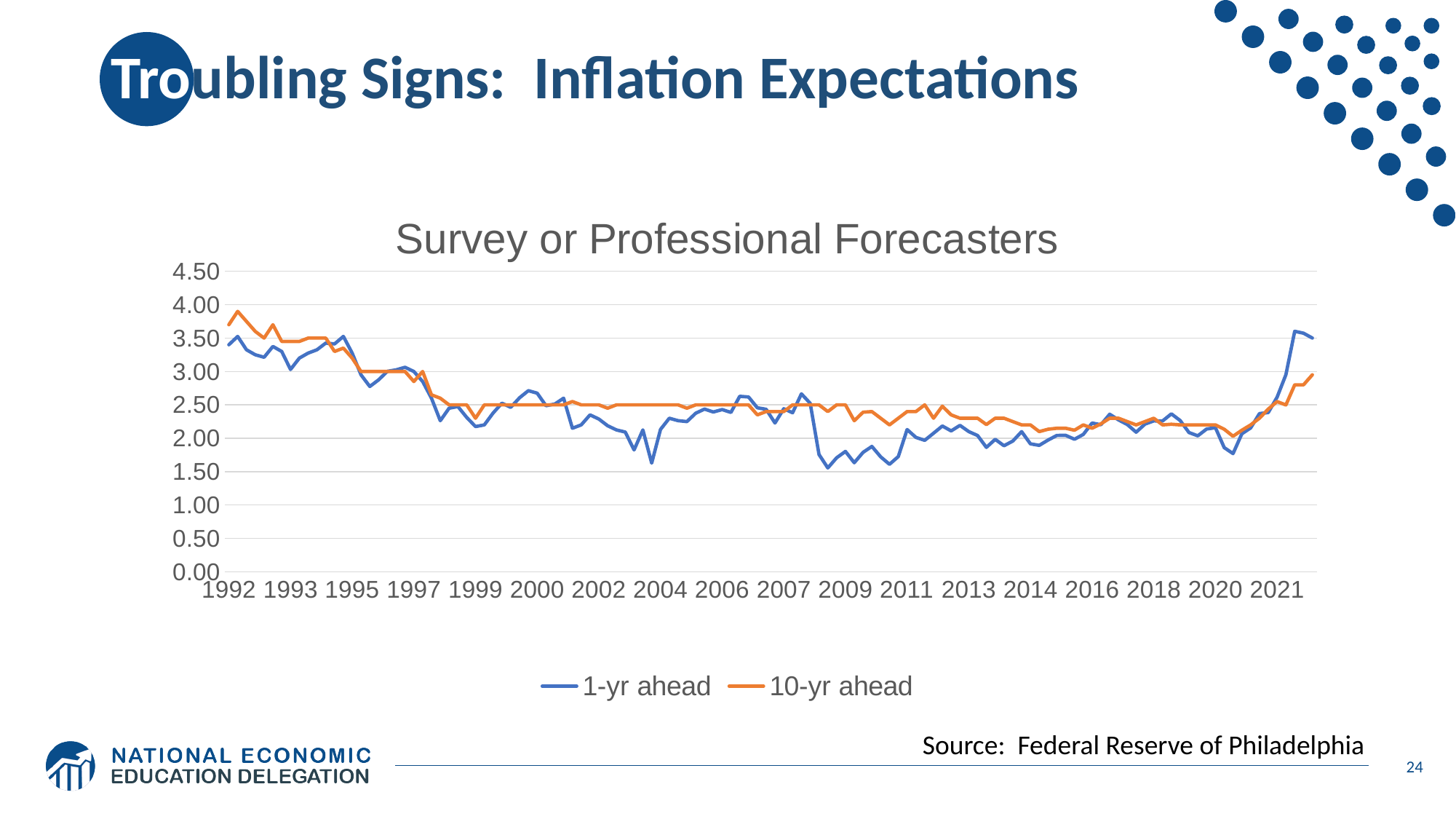
What is the title of the chart? Survey or Professional Forecasters Is the value of the 1-yr ahead series at the end of the chart (2021) greater or less than 3.00? greater Around 2009, which series has the higher value, 1-yr ahead or 10-yr ahead? 10-yr ahead How many year labels are shown on the x axis? 18 Which series is drawn in orange? 10-yr ahead What kind of chart is shown on the slide? Line chart Which series reaches the highest value anywhere on the chart? 10-yr ahead At the right end of the chart (2021), which series has the higher value, 1-yr ahead or 10-yr ahead? 1-yr ahead How many series does the legend list? 2 Is the value of the 10-yr ahead series at the start of 1992 greater or less than 3.00? greater Does the 1-yr ahead series rise or fall between 2020 and 2021? rise Is the lowest value of the 1-yr ahead series around 2009 greater or less than 2.00? less